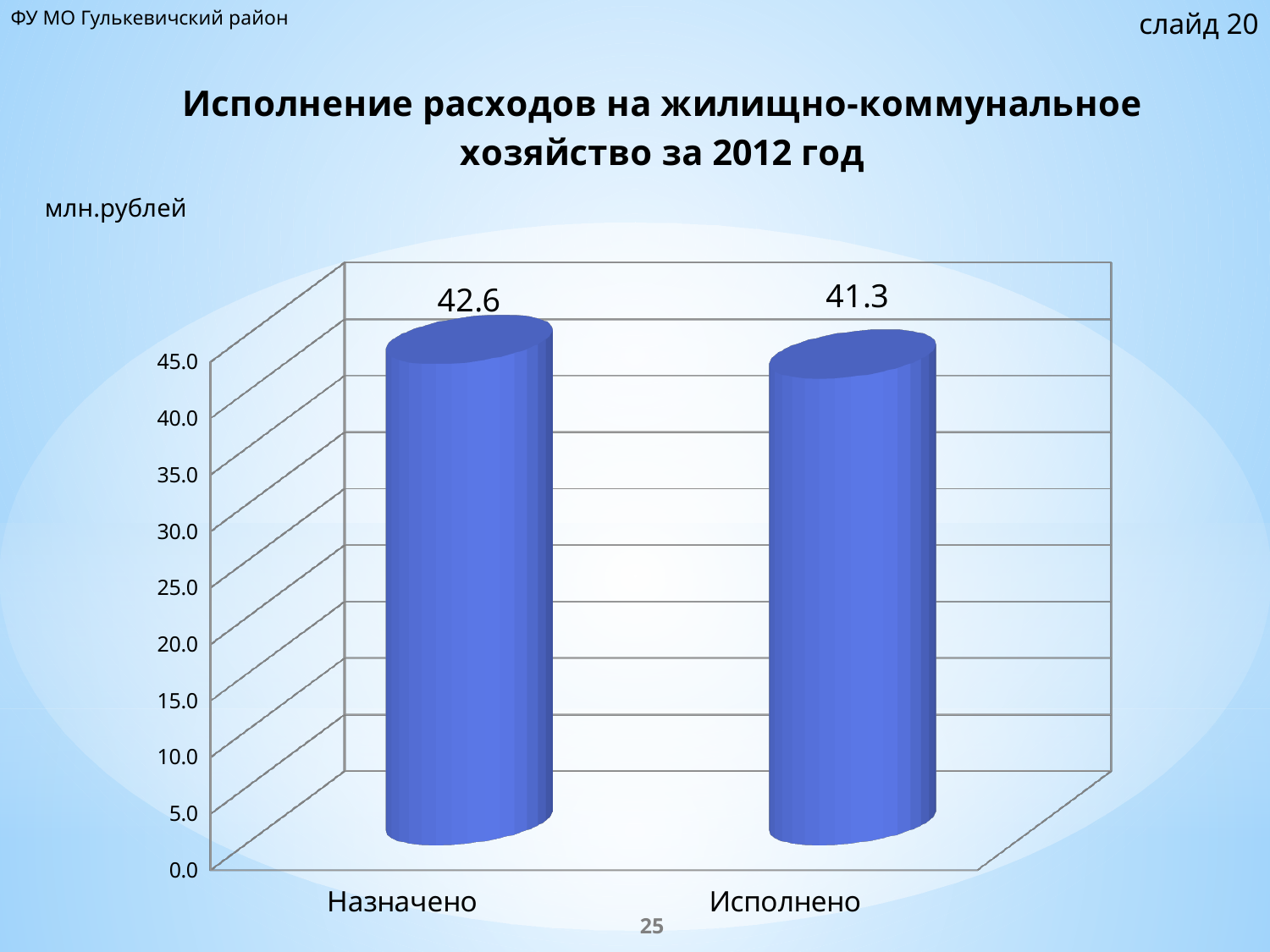
What is the value for Исполнено? 41.3 How many categories are shown on the chart? 2 What is the value for Назначено? 42.6 Which category has the lowest value? Исполнено Is the value for Исполнено greater or less than 40.0? greater What is the difference between the values for Назначено and Исполнено? 1.3 What kind of chart is shown on the slide? bar chart Is the value for Назначено greater or less than 45.0? less Which is larger, the value for Назначено or the value for Исполнено? Назначено What unit is indicated for the chart values? млн.рублей Which category has the highest value? Назначено Do the values rise or fall from Назначено to Исполнено? fall